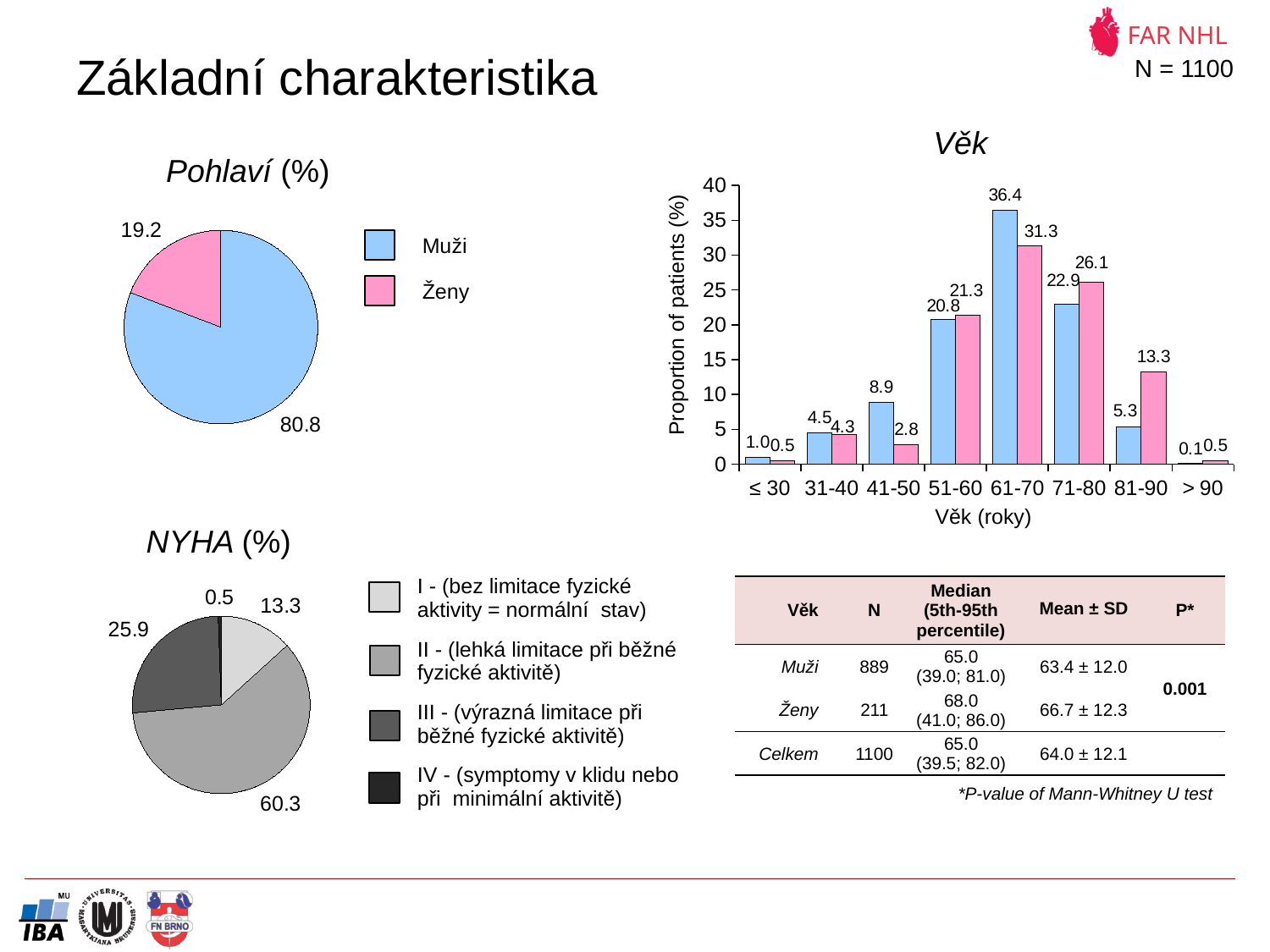
In the Věk bar chart, what is the difference between the blue and pink bars for the 41-50 age group? 6.1 In the Pohlaví (%) pie chart, what is the value for Ženy? 19.2 In the Věk bar chart, which age group has the lowest blue bar? > 90 In the Věk bar chart, how many age groups are shown on the x axis? 8 In the Věk bar chart, what is the value of the blue bar for the 61-70 age group? 36.4 In the NYHA (%) pie chart, what is the largest slice value? 60.3 What type of chart is the Věk chart? bar chart In the Věk bar chart, for the 71-80 age group, is the blue bar or the pink bar larger? pink bar In the Věk bar chart, which age group has the highest blue bar? 61-70 In the Pohlaví (%) pie chart, how many slices are there? 2 In the Pohlaví (%) pie chart, what is the value for Muži? 80.8 In the Věk bar chart, what is the value of the pink bar for the 81-90 age group? 13.3